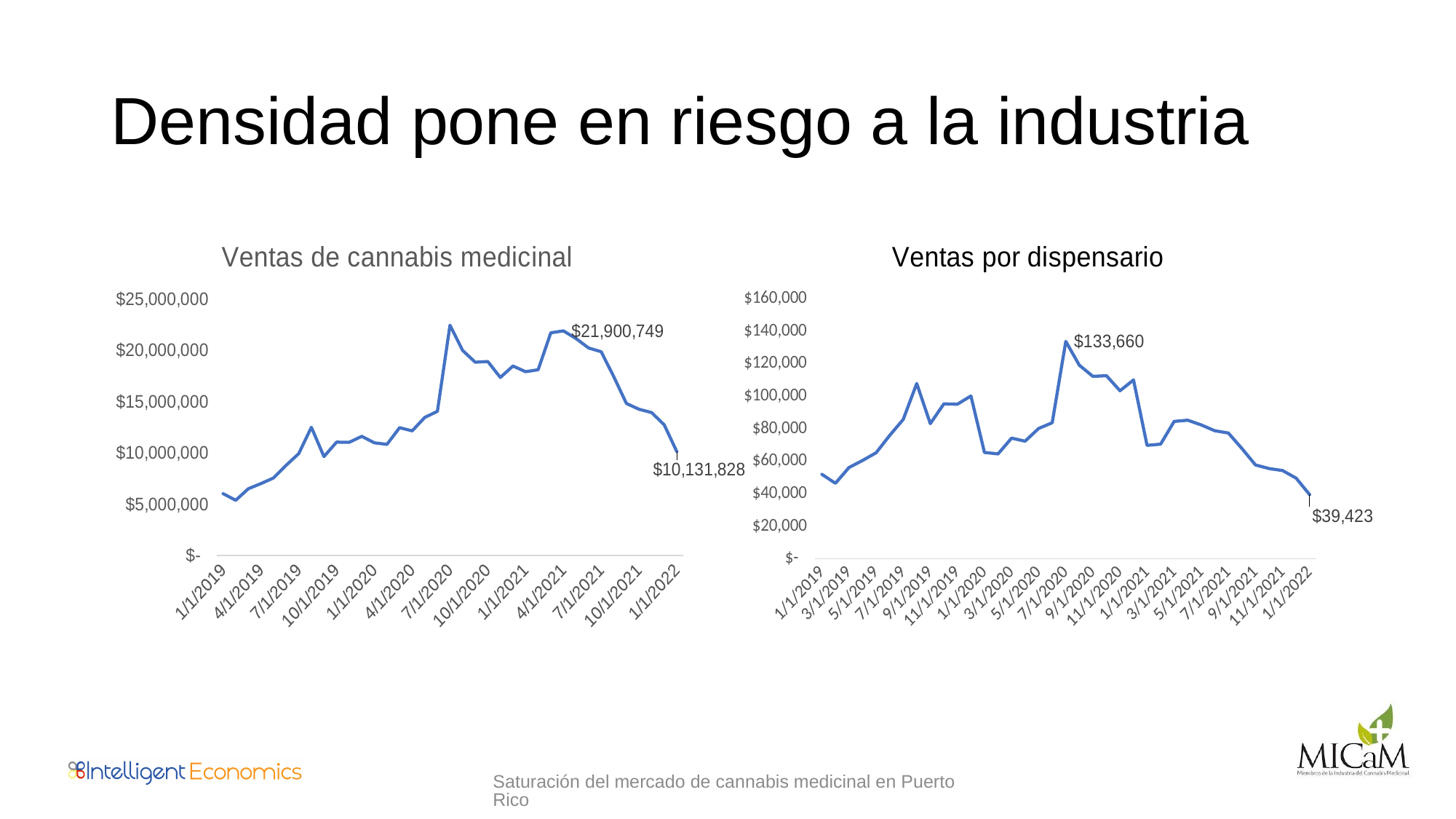
In the 'Ventas de cannabis medicinal' chart, what is the value shown for 1/1/2022? $10,131,828 In the 'Ventas de cannabis medicinal' chart, is the value for 1/1/2019 greater or less than $10,000,000? less In the 'Ventas por dispensario' chart, what is the difference between the labeled peak value and the value at 1/1/2022? $94,237 What kind of chart is 'Ventas por dispensario'? Line chart In the 'Ventas de cannabis medicinal' chart, what is the difference between the labeled value $21,900,749 and the value at 1/1/2022? $11,768,921 In the 'Ventas por dispensario' chart, is the value for 1/1/2019 greater or less than $60,000? less In the 'Ventas de cannabis medicinal' chart, which is larger, the value at 1/1/2019 or the value at 1/1/2022? 1/1/2022 In the 'Ventas por dispensario' chart, do values rise or fall from 7/1/2020 to 1/1/2022? Fall How many charts are shown on the slide? 2 In the 'Ventas por dispensario' chart, what is the value shown for 1/1/2022? $39,423 In the 'Ventas de cannabis medicinal' chart, what value is labeled at the peak near 4/1/2021? $21,900,749 In the 'Ventas por dispensario' chart, what is the highest value shown? $133,660